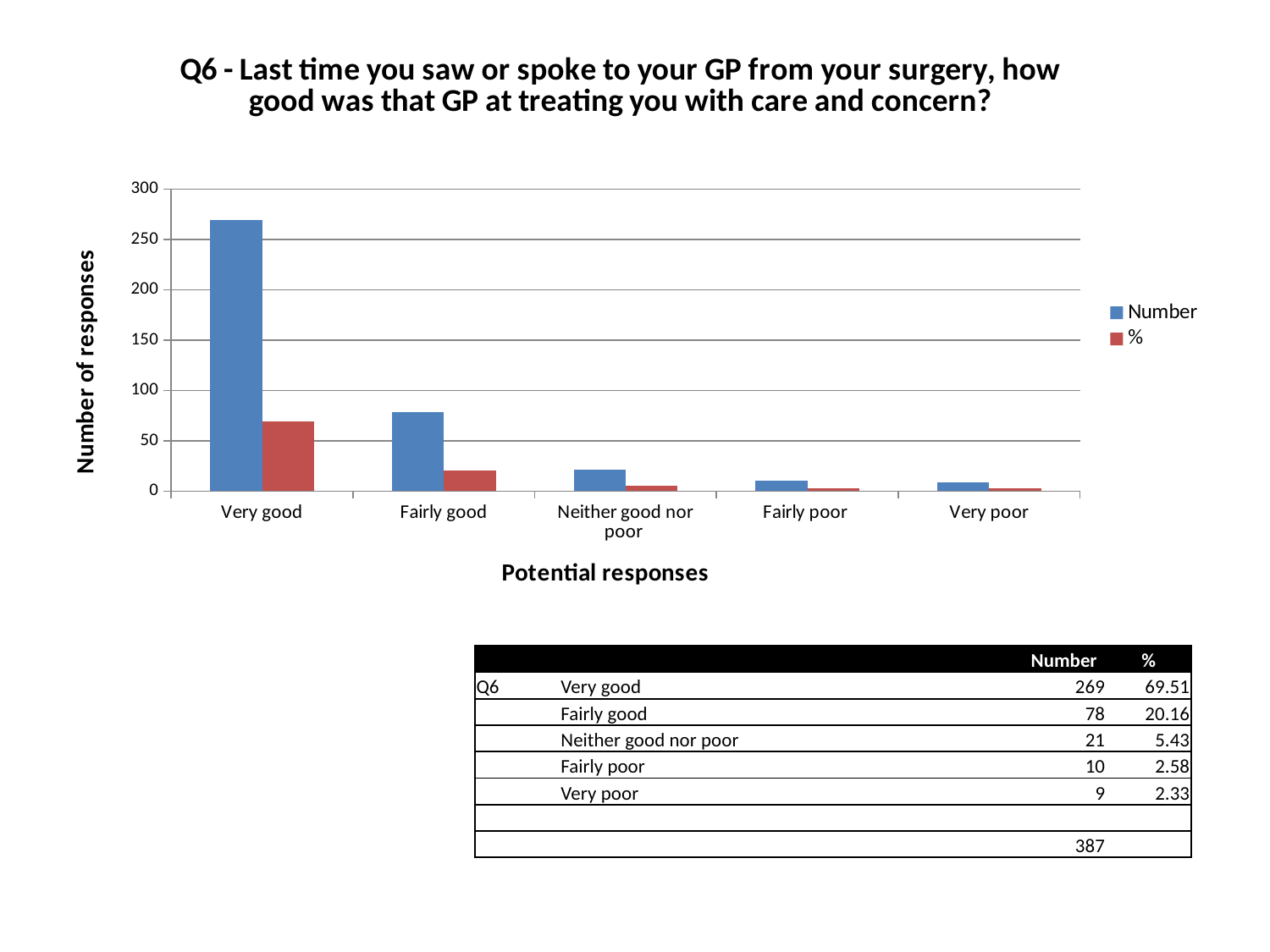
Do the Number values rise or fall moving from Very good to Very poor along the x axis? fall What is the Number value for Fairly good? 78 Which category has the highest Number of responses? Very good Which category has the lowest Number of responses? Very poor What is the difference in Number between Very good and Fairly good? 191 What is the % value for Neither good nor poor? 5.43 What is the Number value for Very good? 269 Is the Number value for Very good greater or less than 250? greater How many series does the chart legend list? 2 What kind of chart is shown on the slide? bar chart Which has a larger Number value, Fairly poor or Very poor? Fairly poor How many response categories are shown on the x axis of the chart? 5